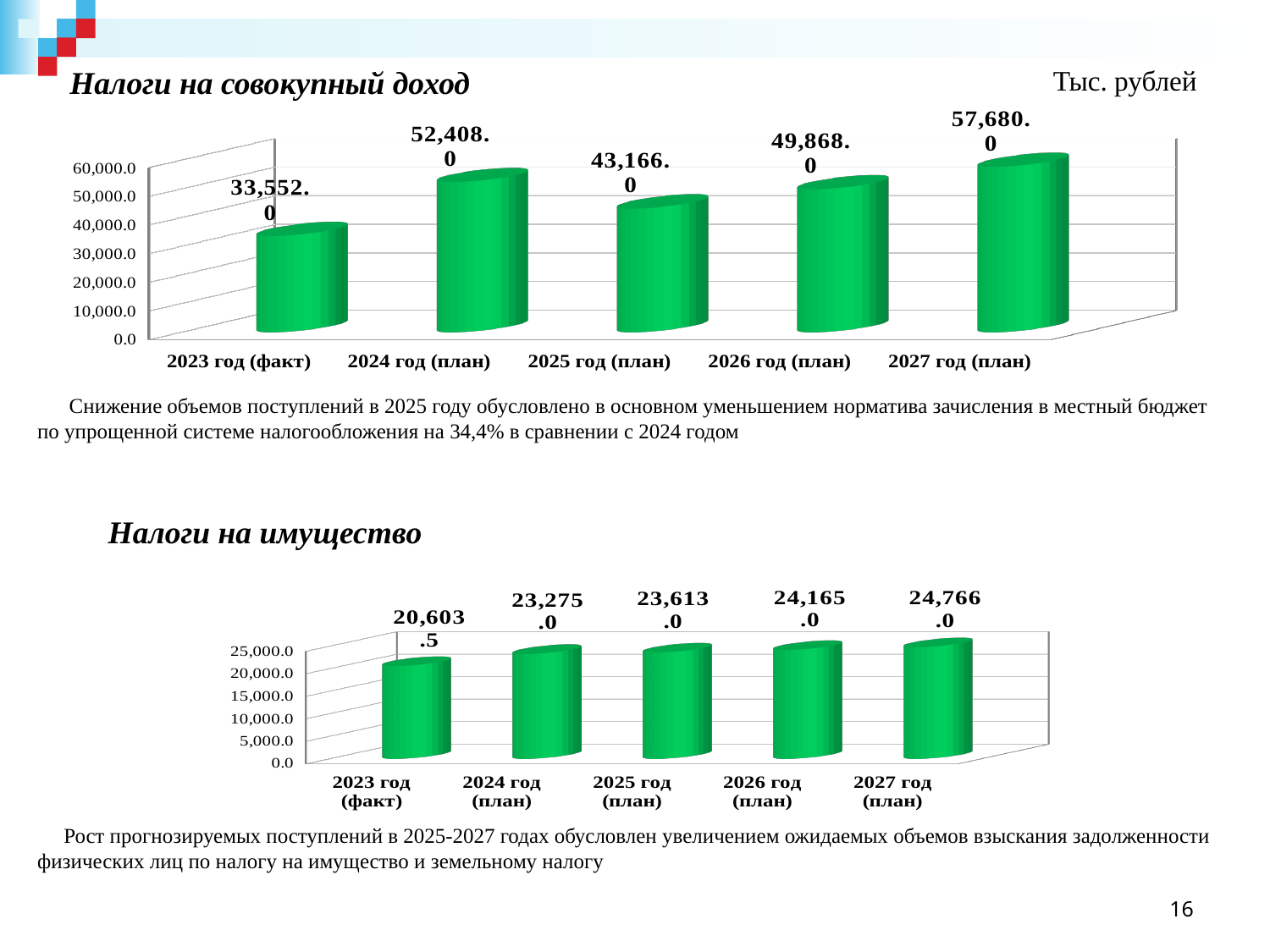
In the chart titled "Налоги на имущество", what is the value for 2023 год (факт)? 20,603.5 In the chart titled "Налоги на имущество", what is the value for 2027 год (план)? 24,766.0 In the chart titled "Налоги на совокупный доход", what is the value for 2024 год (план)? 52,408.0 In the chart titled "Налоги на имущество", what is the difference between the values for 2027 год (план) and 2026 год (план)? 601.0 In the chart titled "Налоги на совокупный доход", which year has the lowest value? 2023 год (факт) What kind of chart is the chart titled "Налоги на имущество"? bar chart In the chart titled "Налоги на совокупный доход", which year has the highest value? 2027 год (план) In the chart titled "Налоги на совокупный доход", what is the difference between the values for 2024 год (план) and 2025 год (план)? 9,242.0 In the chart titled "Налоги на совокупный доход", which is larger: the value for 2025 год (план) or 2026 год (план)? 2026 год (план) In the chart titled "Налоги на совокупный доход", how many years are plotted? 5 In the chart titled "Налоги на имущество", do the values rise or fall from 2023 to 2027? rise What unit is stated at the top right of the slide for the chart values? Тыс. рублей